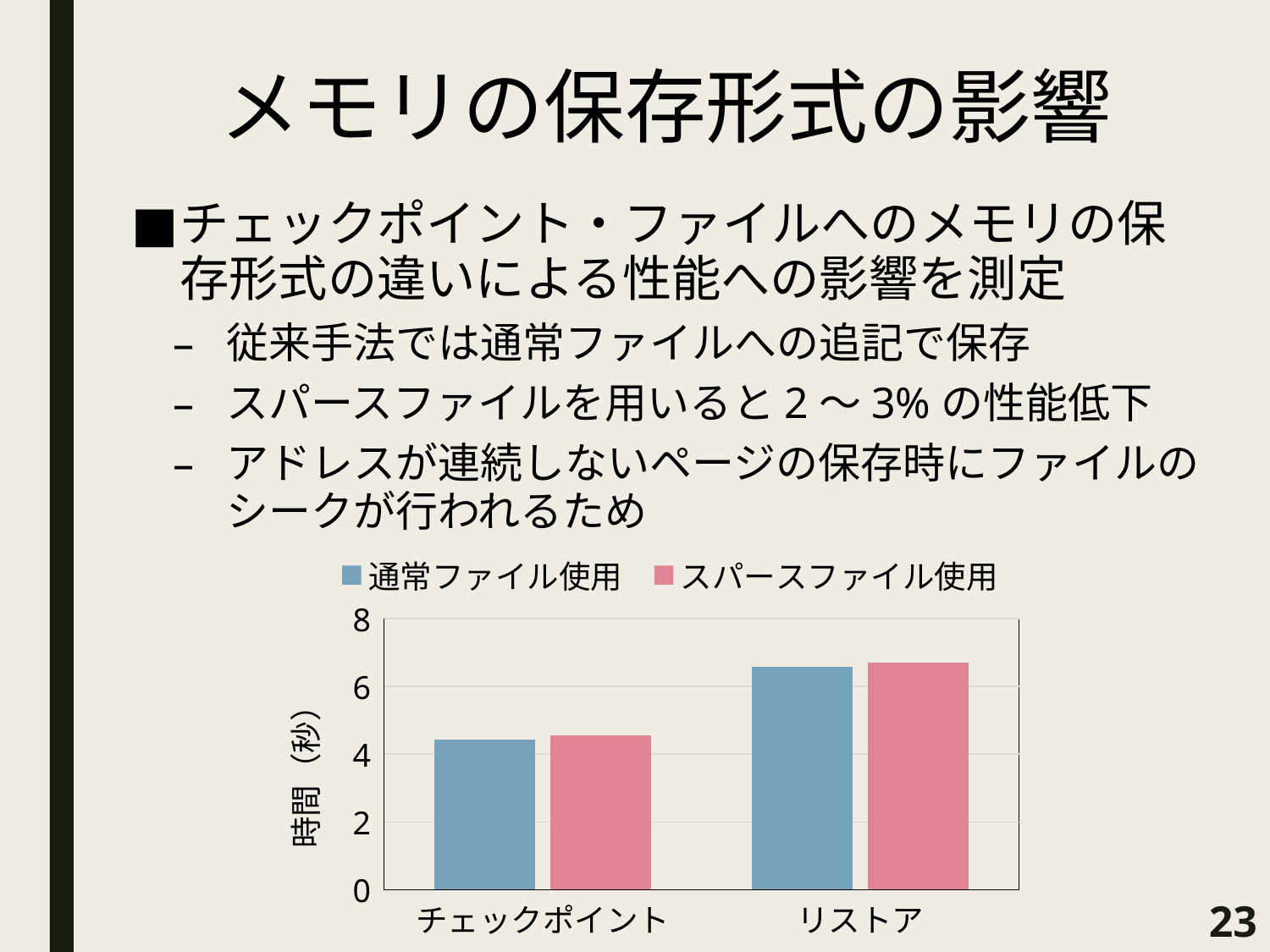
What kind of chart is shown on the slide? bar chart Is the value for 通常ファイル使用 in the チェックポイント category greater or less than 4? greater For the 通常ファイル使用 series, which is larger: チェックポイント or リストア? リストア How many series does the chart legend list? 2 Is the value for スパースファイル使用 in the リストア category greater or less than 8? less Is the value for スパースファイル使用 in the チェックポイント category greater or less than 6? less Which category has the highest bars in the chart? リストア Which category has the lowest bars in the chart? チェックポイント Which series is shown in red/pink in the chart? スパースファイル使用 How many categories are shown on the x axis of the chart? 2 What is the label of the y axis of the chart? 時間（秒）